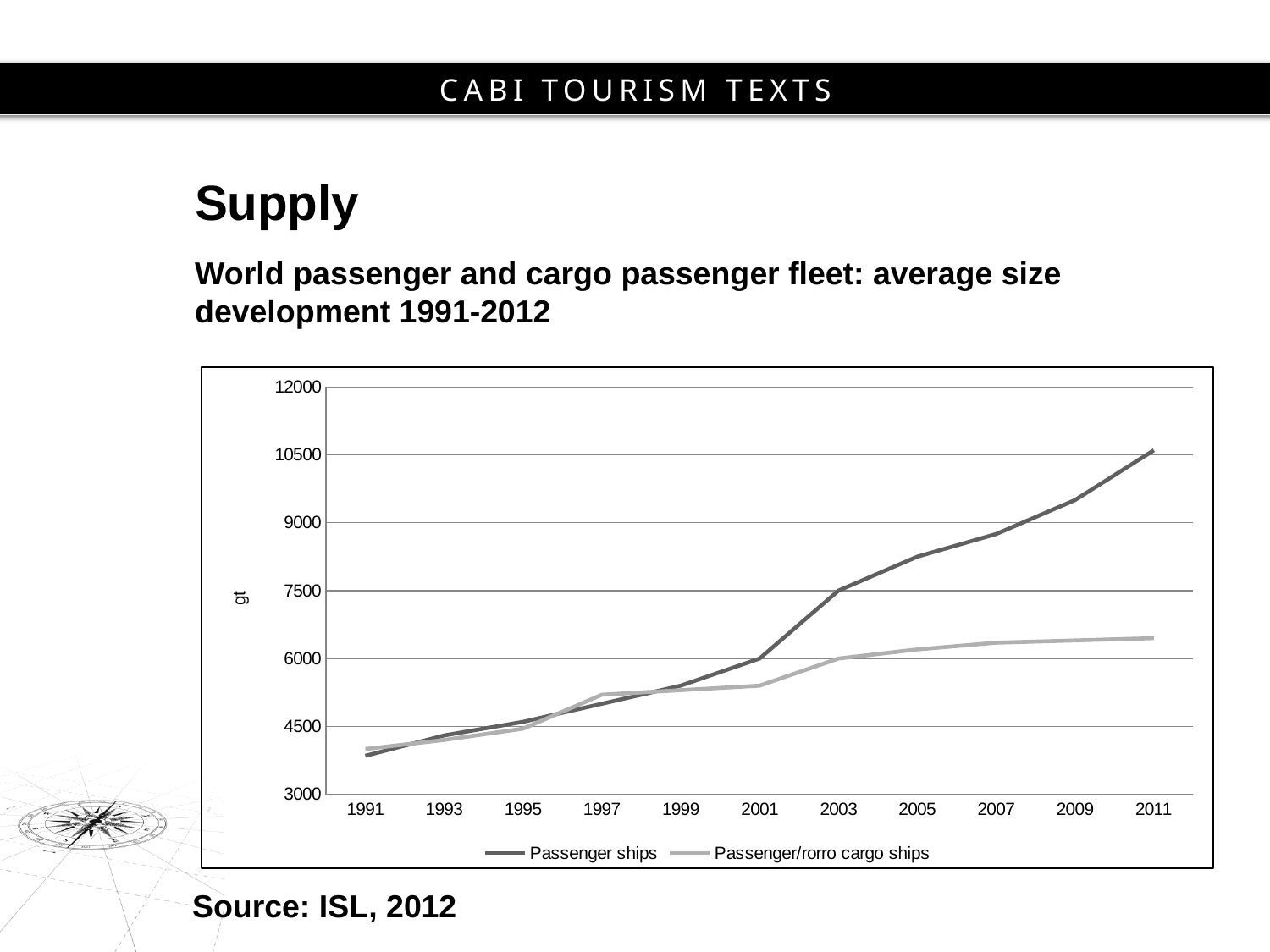
Is the value for Passenger/rorro cargo ships in 2011 greater or less than 7500? less How many series does the chart legend list? 2 What is the name of the second series listed in the chart legend? Passenger/rorro cargo ships Is the value for Passenger/rorro cargo ships in 2007 greater or less than 6000? greater Which series has the higher value in 2011, Passenger ships or Passenger/rorro cargo ships? Passenger ships Is the value for Passenger ships in 1991 greater or less than 4500? less What kind of chart is shown on the slide? line chart How many years are labelled along the x axis of the chart? 11 Do the values for Passenger ships rise or fall from 1991 to 2011? rise What is the label on the y axis of the chart? gt